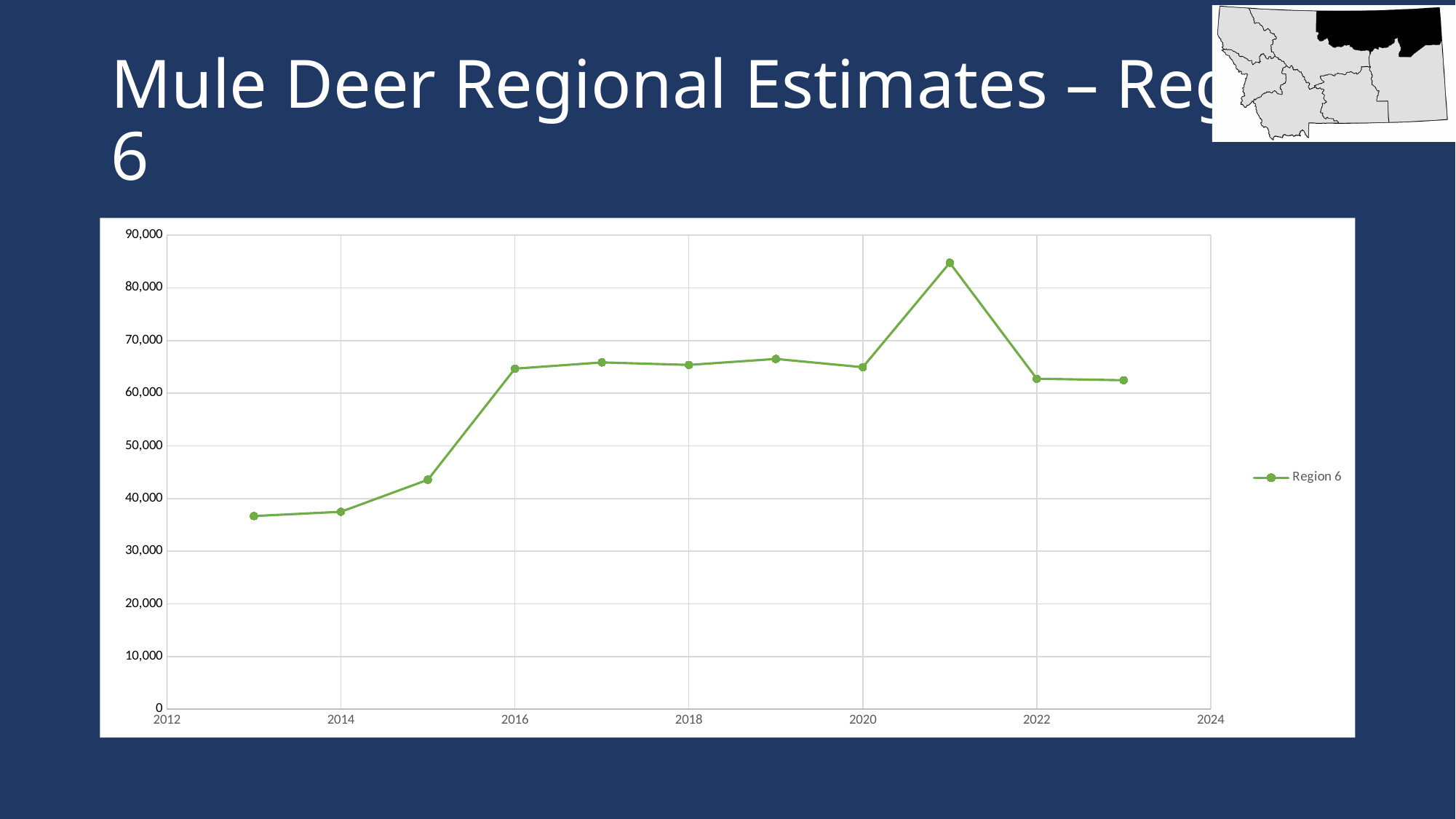
Is the Region 6 value for 2015 greater or less than 50,000? less Do the Region 6 values rise or fall from 2013 to 2016? rise Is the Region 6 value for 2021 greater or less than 80,000? greater Which year has the larger Region 6 estimate, 2015 or 2016? 2016 What kind of chart is shown on the slide? line chart Is the Region 6 value for 2013 greater or less than 40,000? less What is the name of the series shown in the legend? Region 6 In which year does the Region 6 estimate reach its highest value? 2021 How many series does the legend list? 1 How many data points are plotted on the Region 6 line? 11 Which year has the larger Region 6 estimate, 2021 or 2022? 2021